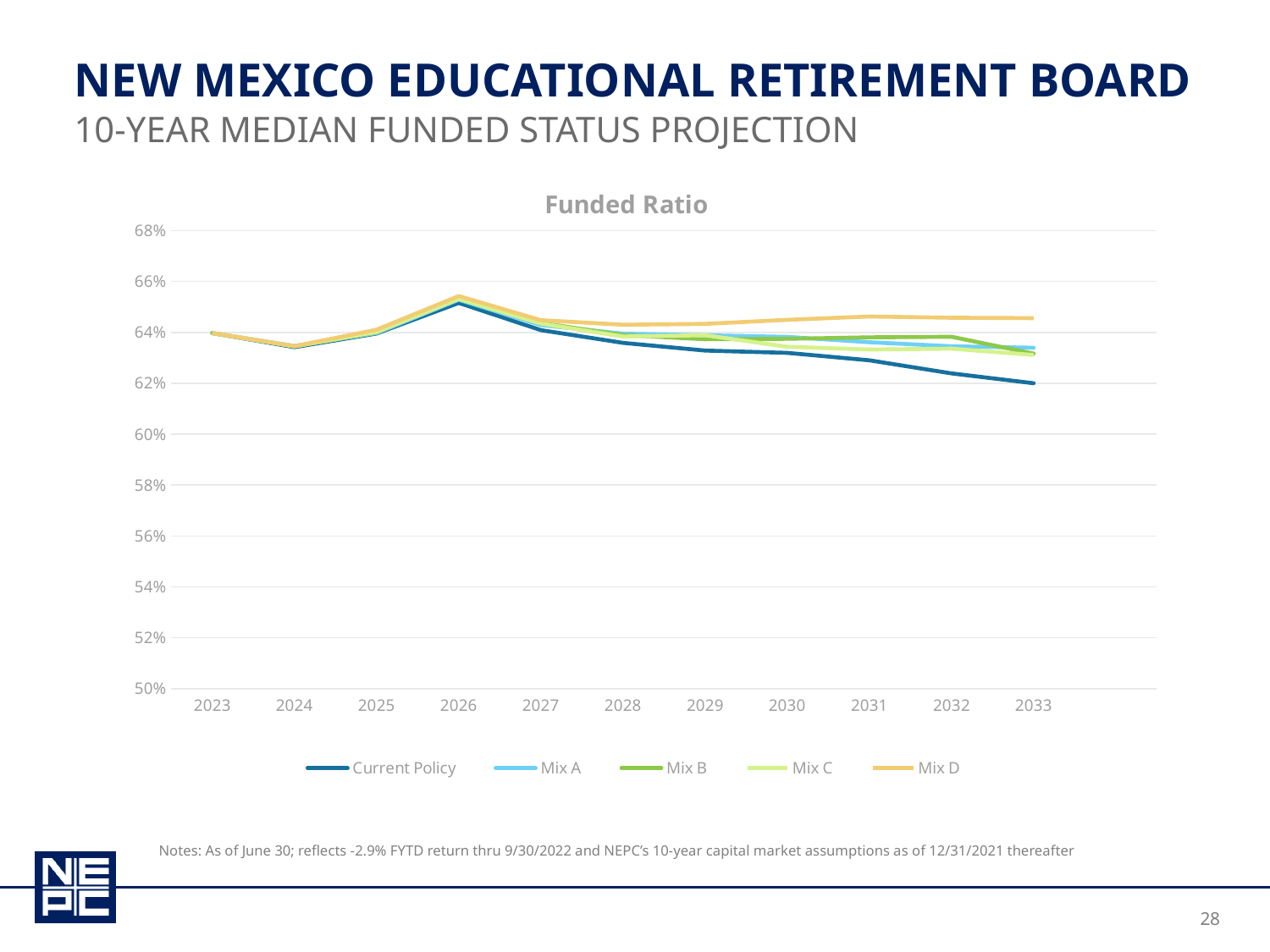
What is the title of the chart? Funded Ratio How many series does the legend list? 5 Which series has the highest funded ratio in 2033? Mix D How many years are shown along the x axis? 11 What kind of chart is shown on the slide? line chart Which series has the lowest funded ratio in 2033? Current Policy What is the first series listed in the legend? Current Policy Does the Current Policy funded ratio rise or fall from 2026 to 2033? fall Is the funded ratio for Mix D in 2026 greater or less than 66%? less Is the funded ratio for Mix D in 2033 greater or less than 64%? greater Is the funded ratio for Current Policy in 2030 greater or less than 64%? less In 2031, which is larger: the funded ratio for Mix D or for Current Policy? Mix D